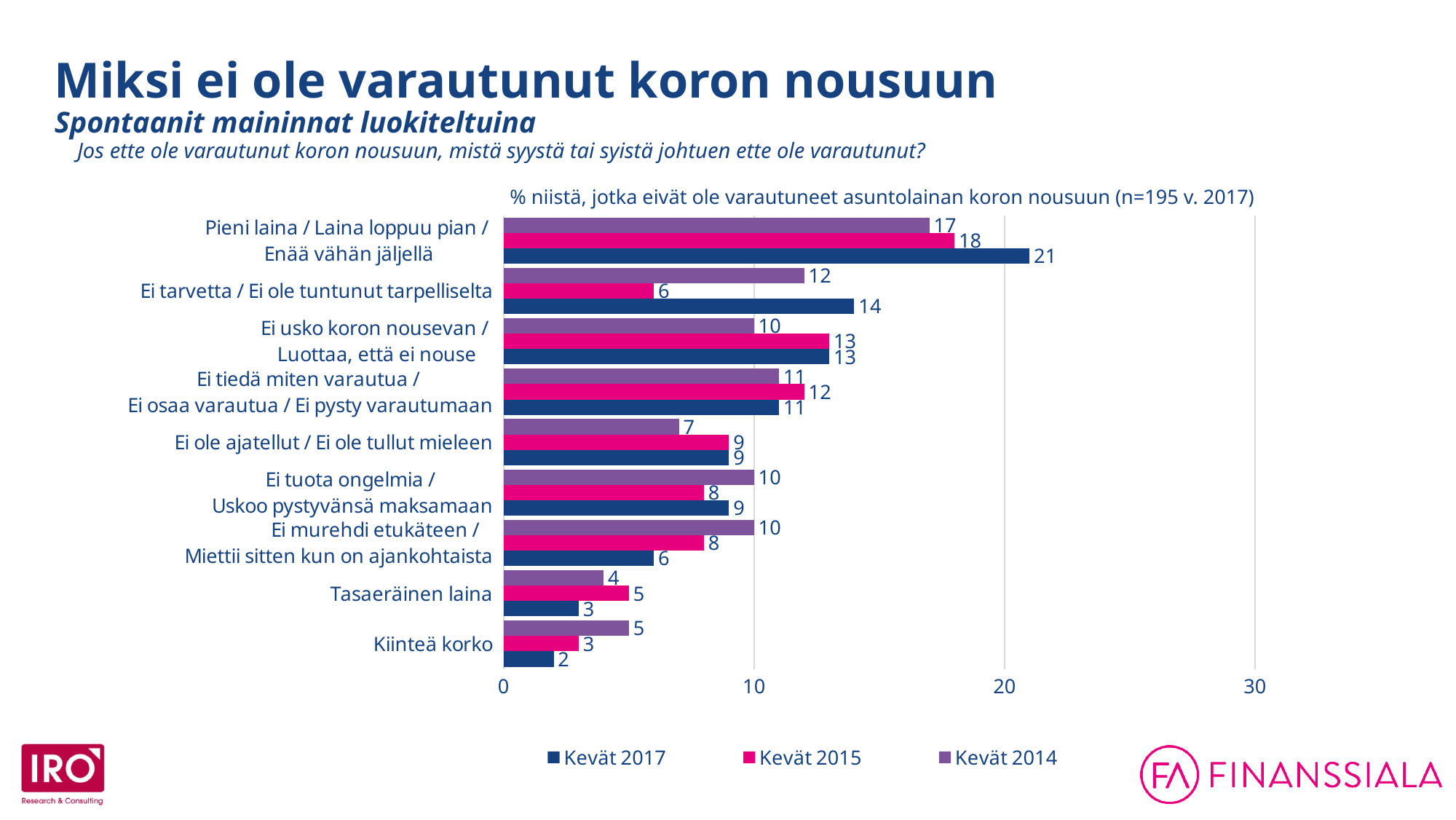
What is the Kevät 2015 value for "Ei tarvetta / Ei ole tuntunut tarpelliselta"? 6 What is the difference between the Kevät 2017 and Kevät 2015 values for "Ei tarvetta / Ei ole tuntunut tarpelliselta"? 8 What is the Kevät 2014 value for "Kiinteä korko"? 5 What is the Kevät 2017 value for "Pieni laina / Laina loppuu pian / Enää vähän jäljellä"? 21 How many series does the legend list? 3 Is the Kevät 2017 value for "Pieni laina / Laina loppuu pian / Enää vähän jäljellä" greater or less than 20? greater Which category has the highest Kevät 2017 value? Pieni laina / Laina loppuu pian / Enää vähän jäljellä For "Ei murehdi etukäteen / Miettii sitten kun on ajankohtaista", which is larger: the Kevät 2014 value or the Kevät 2017 value? Kevät 2014 How many categories (reasons) are shown on the chart? 9 Which category has the lowest Kevät 2017 value? Kiinteä korko Which series is shown in dark blue in the legend? Kevät 2017 What kind of chart is shown on the slide? Bar chart